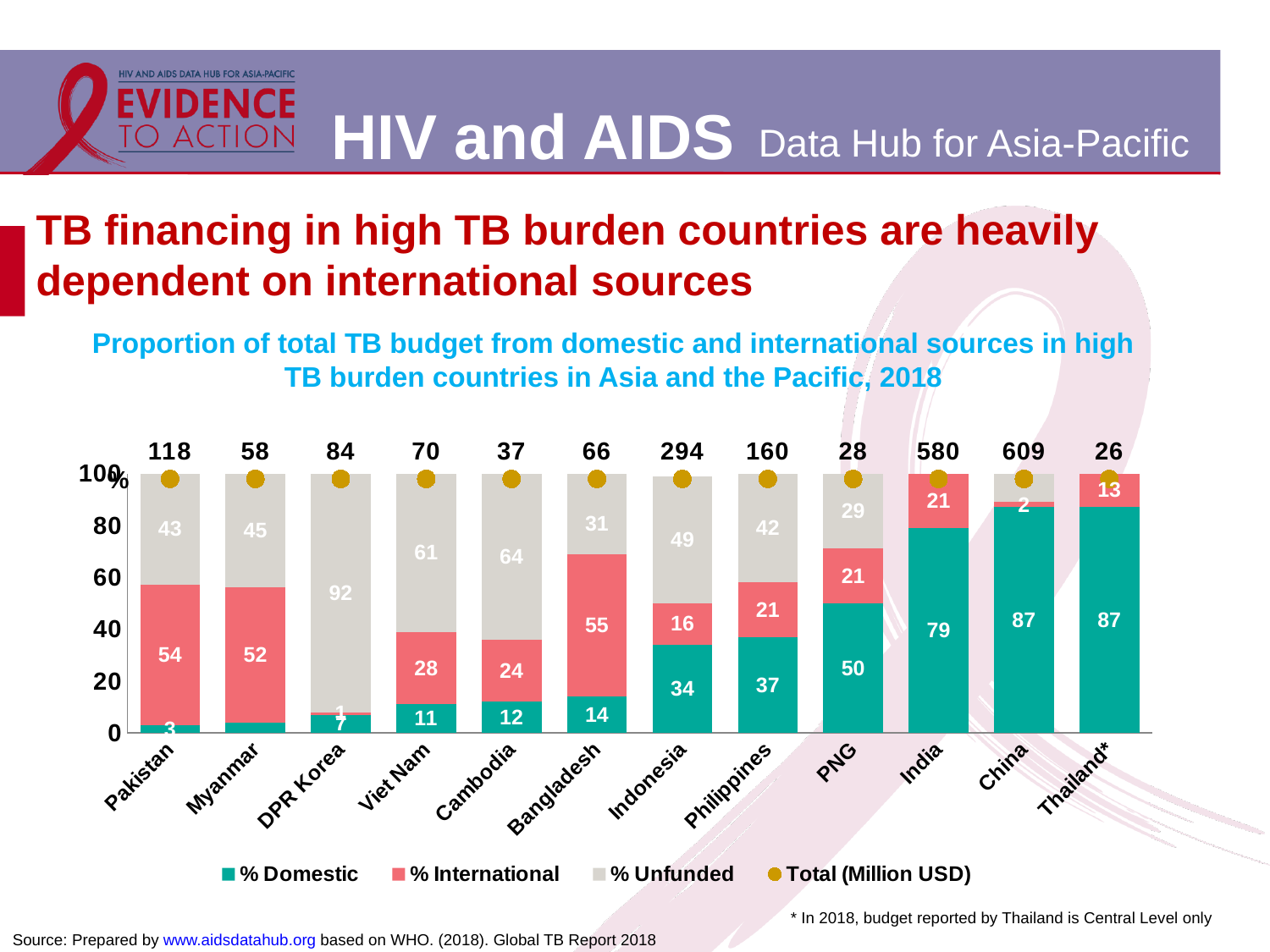
How many countries are shown on the x axis of the chart? 12 Which country has the highest Total (Million USD)? China Which country has the lowest Total (Million USD)? Thailand* What is the % Unfunded value for DPR Korea? 92 How many series does the chart legend list? 4 Is the % Domestic value for Myanmar greater or less than 20? less Which has a larger % Domestic value, Indonesia or the Philippines? Philippines What kind of chart is shown on the slide? bar chart What is the Total (Million USD) value shown for China? 609 Which country has the highest % Unfunded value? DPR Korea What is the difference between the Total (Million USD) for China and for India? 29 What is the % International value for Bangladesh? 55